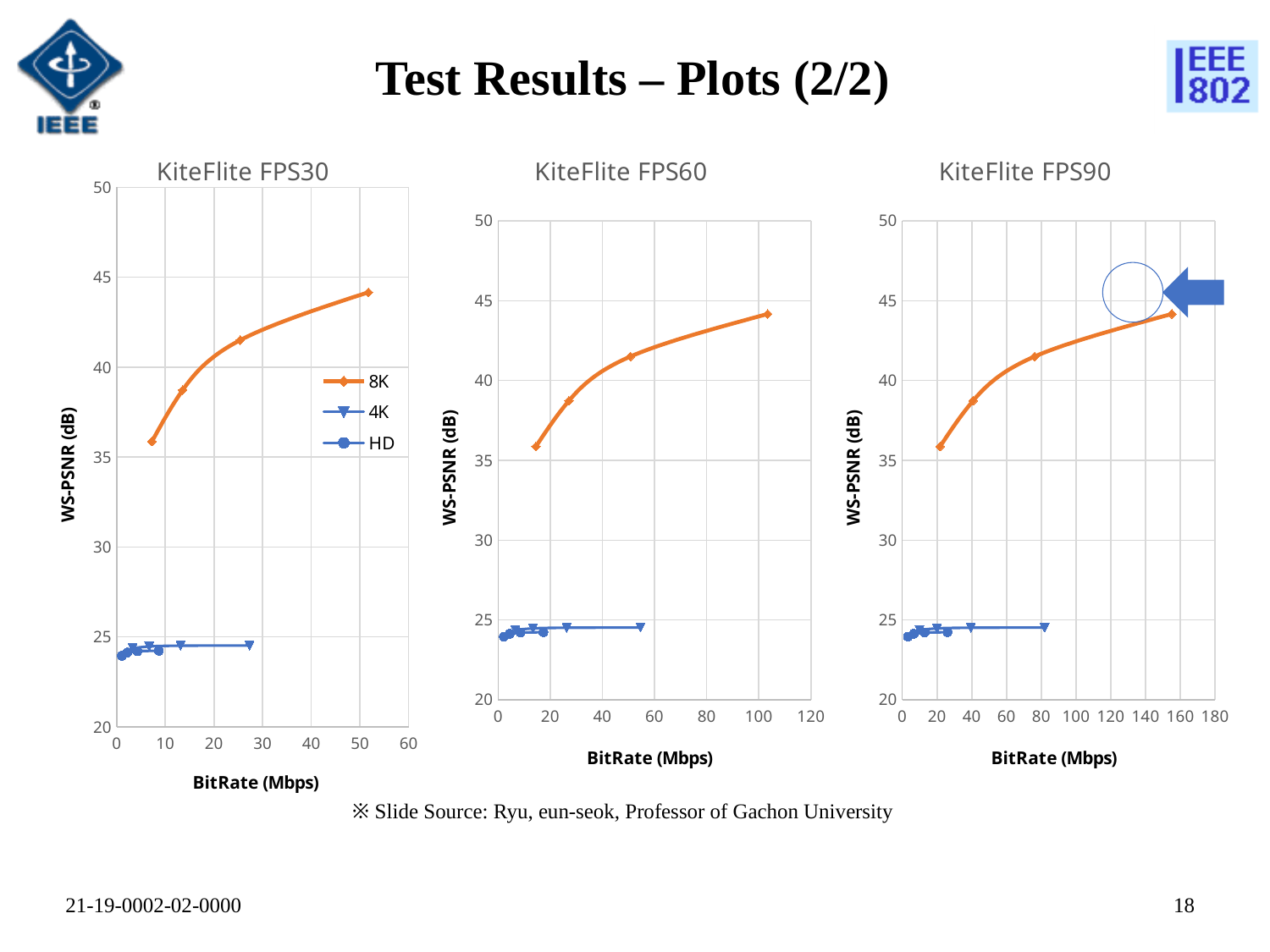
In the KiteFlite FPS90 chart, which series reaches the highest WS-PSNR? 8K How many series does the legend on the KiteFlite FPS30 chart list? 3 What kind of chart is the KiteFlite FPS30 chart? line chart In the KiteFlite FPS60 chart, which series has higher WS-PSNR values, 8K or 4K? 8K In the KiteFlite FPS30 chart, how many data points does the 8K series have? 4 What is the y-axis label of the KiteFlite FPS60 chart? WS-PSNR (dB) In the KiteFlite FPS60 chart, does the WS-PSNR of the 8K series rise or fall as BitRate increases? rise What is the title of the rightmost chart on the slide? KiteFlite FPS90 In the KiteFlite FPS60 chart, is the lowest WS-PSNR value of the 8K series greater or less than 40? less In the KiteFlite FPS90 chart, are the WS-PSNR values of the 4K series greater or less than 30? less In the KiteFlite FPS90 chart, what is the highest BitRate value shown on the x axis? 180 In the KiteFlite FPS30 chart, is the highest WS-PSNR value of the 8K series greater or less than 40? greater